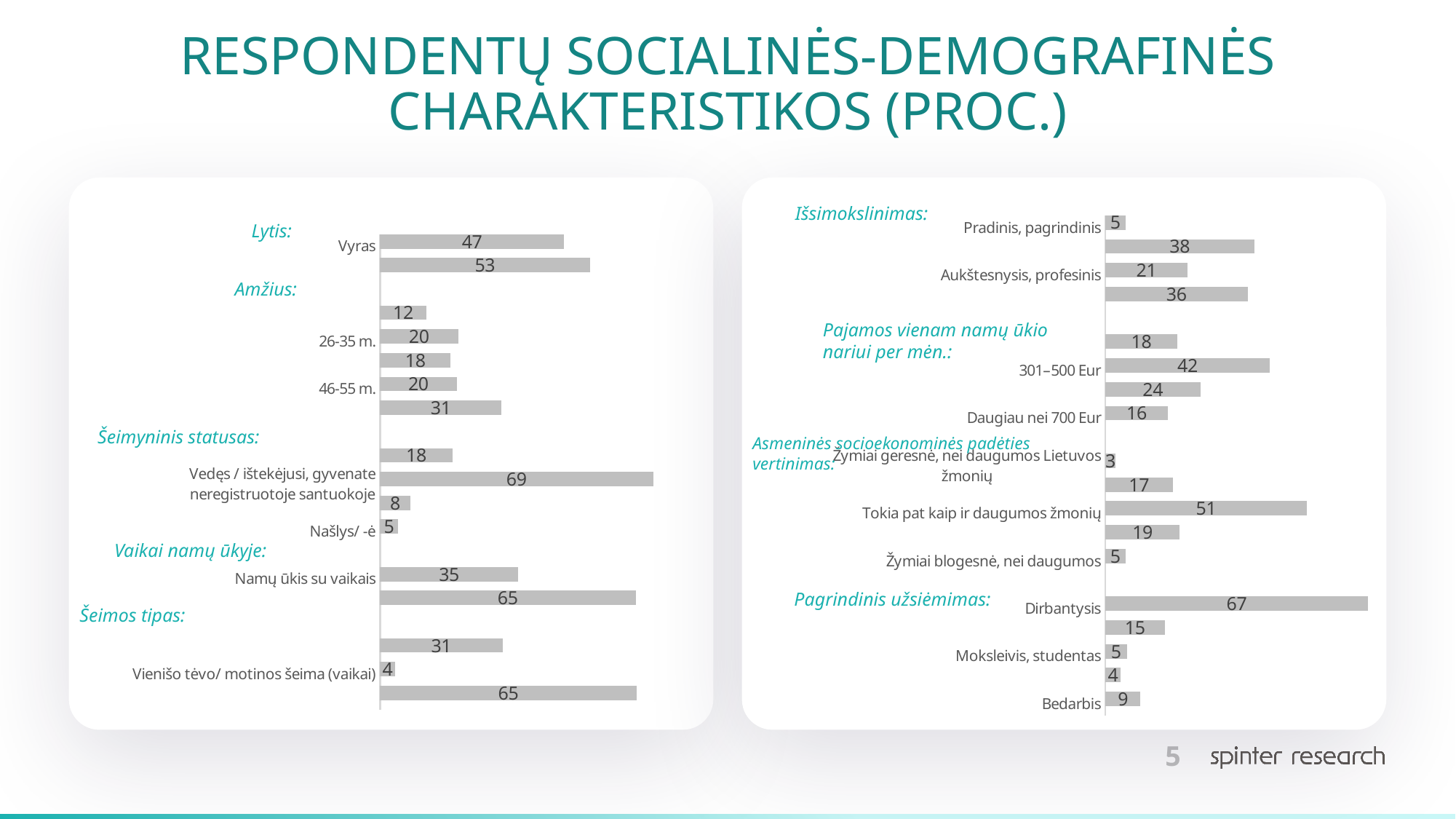
On the right chart, which labelled category has the highest value? Dirbantysis On the right chart, what is the difference between the values for Dirbantysis and Bedarbis? 58 On the right chart, which labelled category has the lowest value? Žymiai geresnė, nei daugumos Lietuvos žmonių On the right chart, what is the value for 301–500 Eur? 42 On the right chart, what is the value for Bedarbis? 9 On the left chart, what is the value for Vyras? 47 On the left chart, what is the difference between the values for Namų ūkis su vaikais and Vienišo tėvo/ motinos šeima (vaikai)? 31 What kind of chart is shown on the left of the slide? Bar chart On the right chart, what is the value for Tokia pat kaip ir daugumos žmonių? 51 On the left chart, what is the value for Vedęs / ištekėjusi, gyvenate neregistruotoje santuokoje? 69 On the right chart, which is larger: the value for 301–500 Eur or for Daugiau nei 700 Eur? 301–500 Eur On the left chart, what is the value for Namų ūkis su vaikais? 35